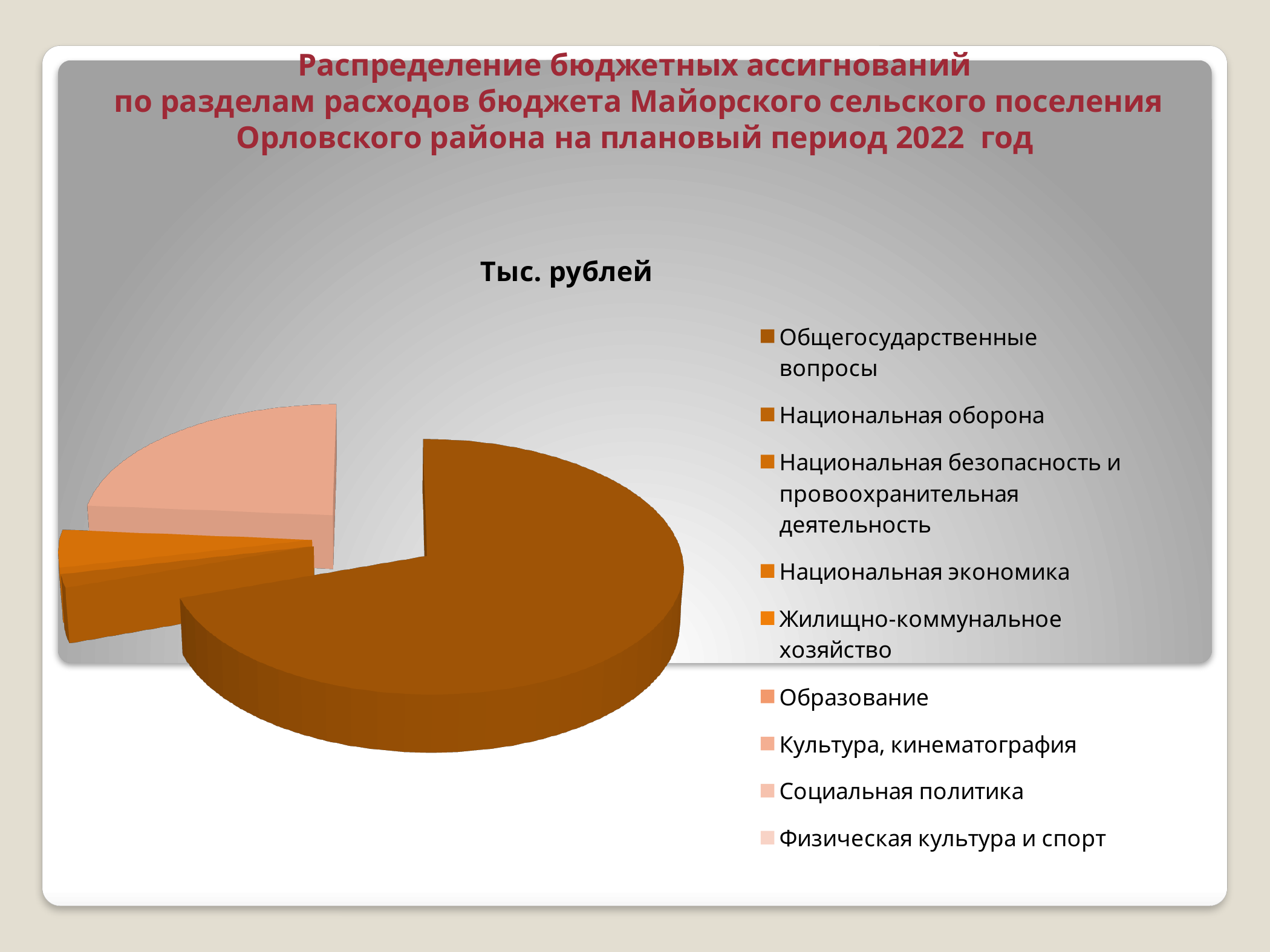
Which legend entry is listed last? Физическая культура и спорт How many entries does the chart legend list? 9 Which category has the largest slice of the pie? Общегосударственные вопросы What kind of chart is shown on the slide? Pie chart Is the slice for Общегосударственные вопросы larger or smaller than the slice for Культура, кинематография? Larger What is the title shown above the pie chart? Тыс. рублей